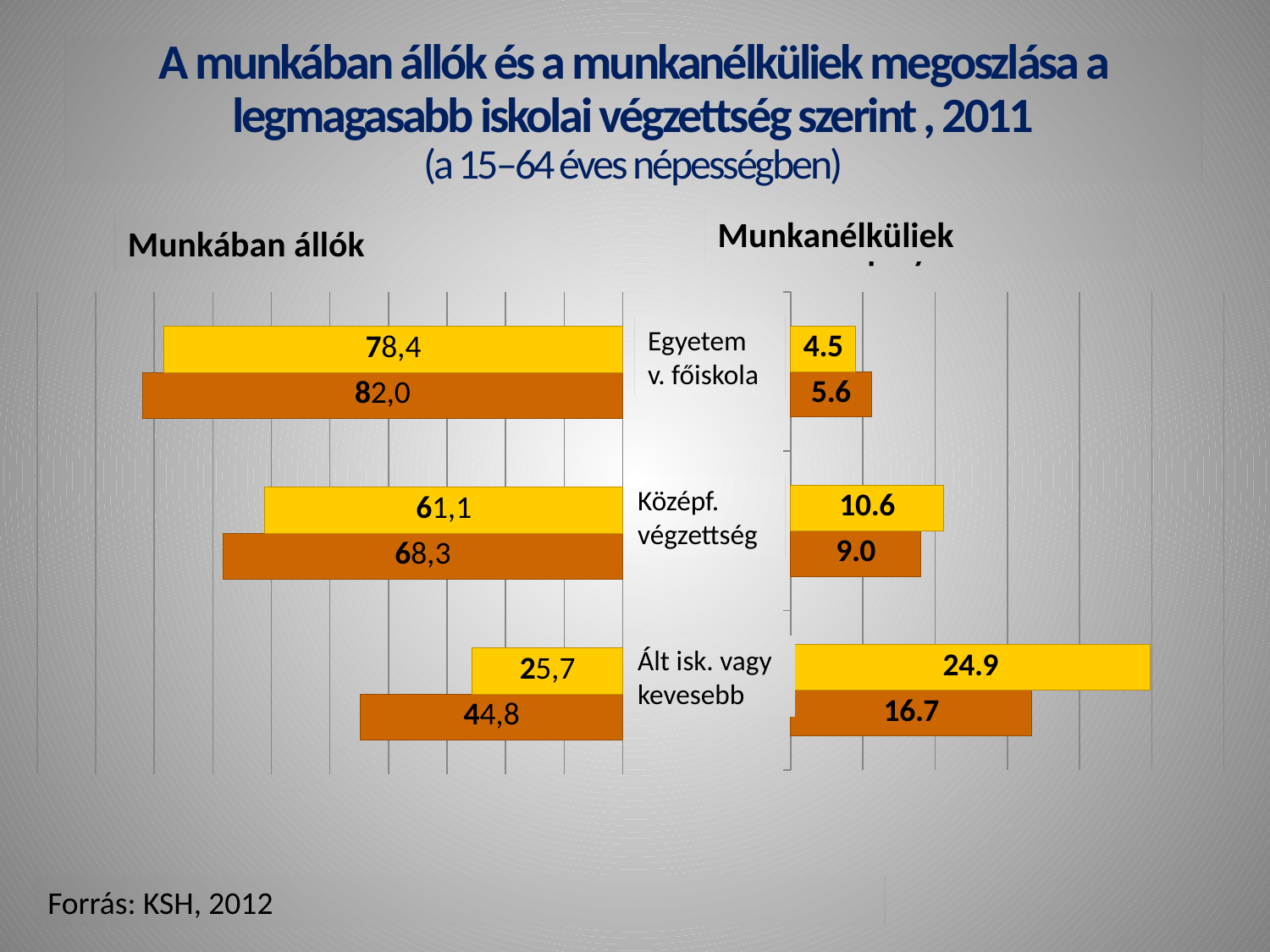
In the Munkában állók chart, what is the difference between the orange and yellow bar values for Ált isk. vagy kevesebb? 19,1 In the Munkanélküliek chart, which is larger for Középf. végzettség: the yellow bar or the orange bar? the yellow bar In the Munkanélküliek chart, which category has the lowest yellow bar value? Egyetem v. főiskola In the Munkában állók chart, what is the value of the yellow bar for Egyetem v. főiskola? 78,4 What type of chart is the Munkanélküliek chart? bar chart What is the source cited at the bottom of the slide? KSH, 2012 In the Munkanélküliek chart, what is the difference between the yellow and orange bar values for Ált isk. vagy kevesebb? 8.2 In the Munkanélküliek chart, what is the value of the orange bar for Egyetem v. főiskola? 5.6 In the Munkában állók chart, what is the value of the orange bar for Ált isk. vagy kevesebb? 44,8 In the Munkában állók chart, which category has the highest orange bar value? Egyetem v. főiskola How many education categories are shown in the Munkában állók chart? 3 In the Munkanélküliek chart, what is the value of the yellow bar for Középf. végzettség? 10.6